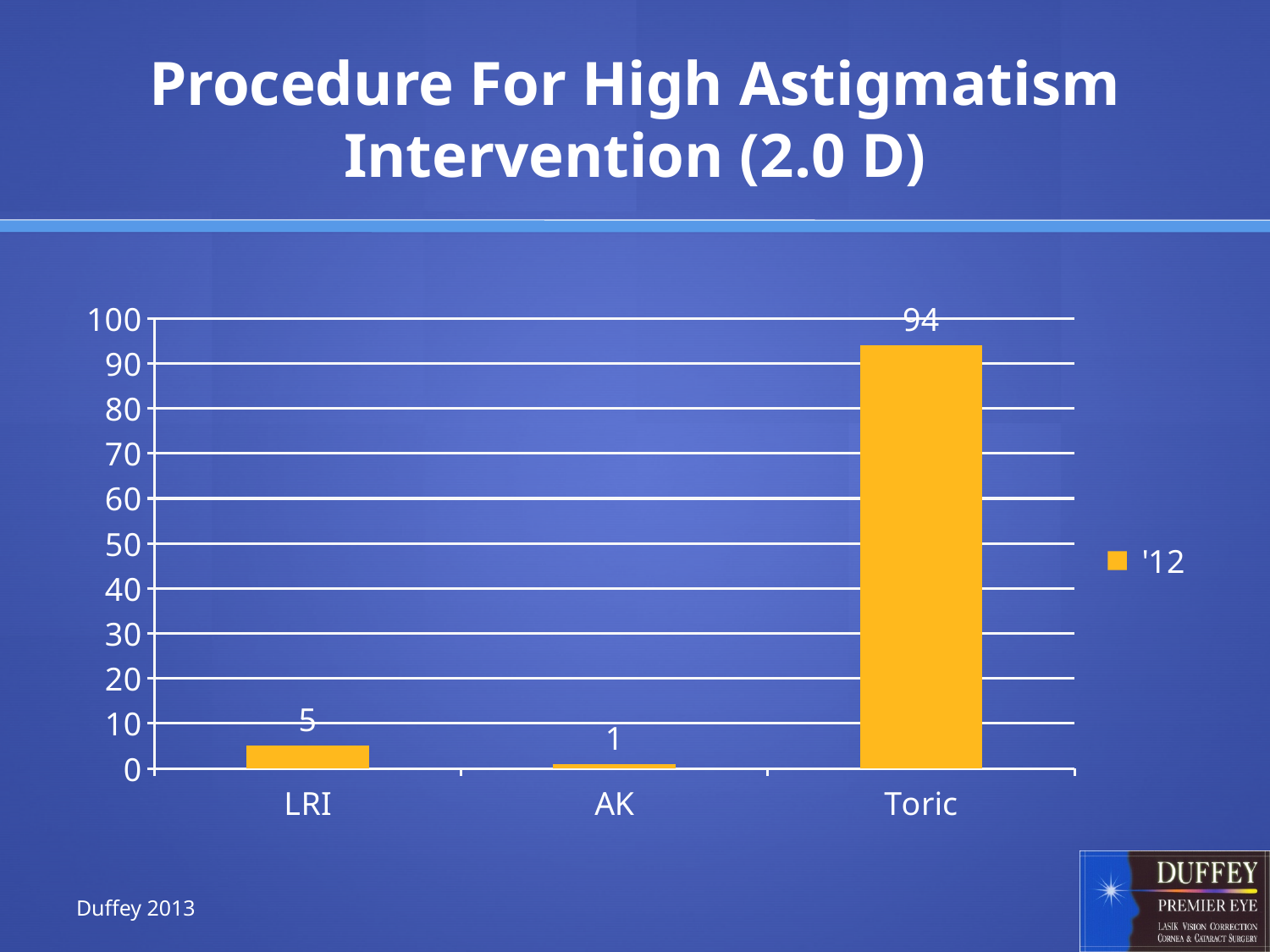
Which category has the highest value? Toric What is the difference between the values for Toric and LRI? 89 Which is larger, the value for LRI or the value for AK? LRI Which category has the lowest value? AK What is the value for LRI? 5 What is the value for AK? 1 How many series does the legend list? 1 What kind of chart is shown on the slide? bar chart Is the value for Toric greater or less than 90? greater How many categories are shown on the x axis? 3 What is the value for Toric? 94 What is the difference between the values for LRI and AK? 4